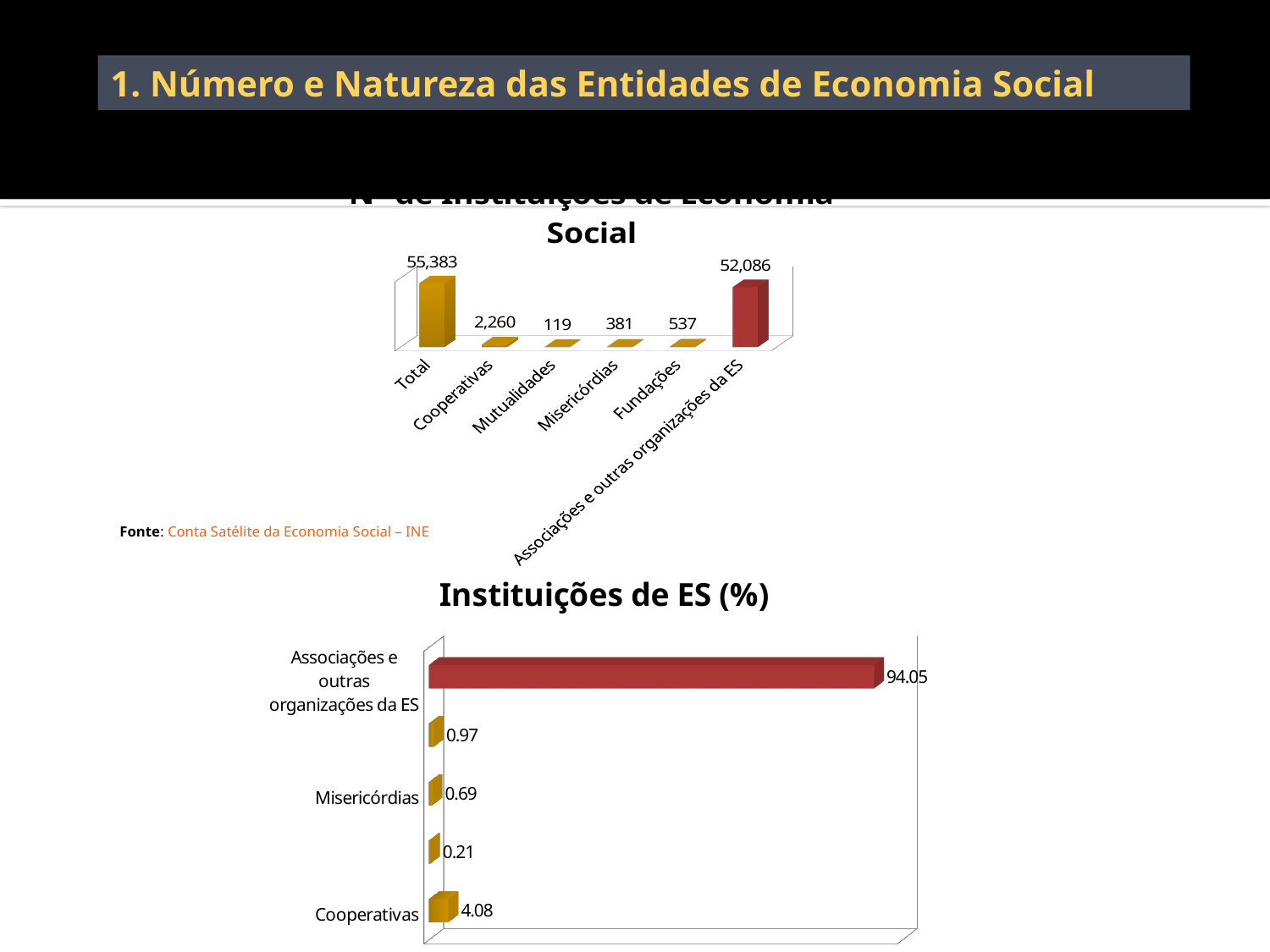
How many categories are shown in the top chart? 6 In the top chart, what is the difference between the values for Fundações and Misericórdias? 156 In the top chart, what is the value for Associações e outras organizações da ES? 52,086 In the top chart, which is larger, the value for Fundações or the value for Misericórdias? Fundações What kind of chart is the bottom chart titled 'Instituições de ES (%)'? Bar chart In the top chart, which category has the lowest value? Mutualidades In the top chart, what is the value for Cooperativas? 2,260 In the bottom chart 'Instituições de ES (%)', what is the value for Cooperativas? 4.08 In the top chart, what is the value for Mutualidades? 119 In the bottom chart 'Instituições de ES (%)', what is the value for Associações e outras organizações da ES? 94.05 In the top chart, which category has the highest value? Total In the bottom chart 'Instituições de ES (%)', what is the difference between the values for Associações e outras organizações da ES and Cooperativas? 89.97